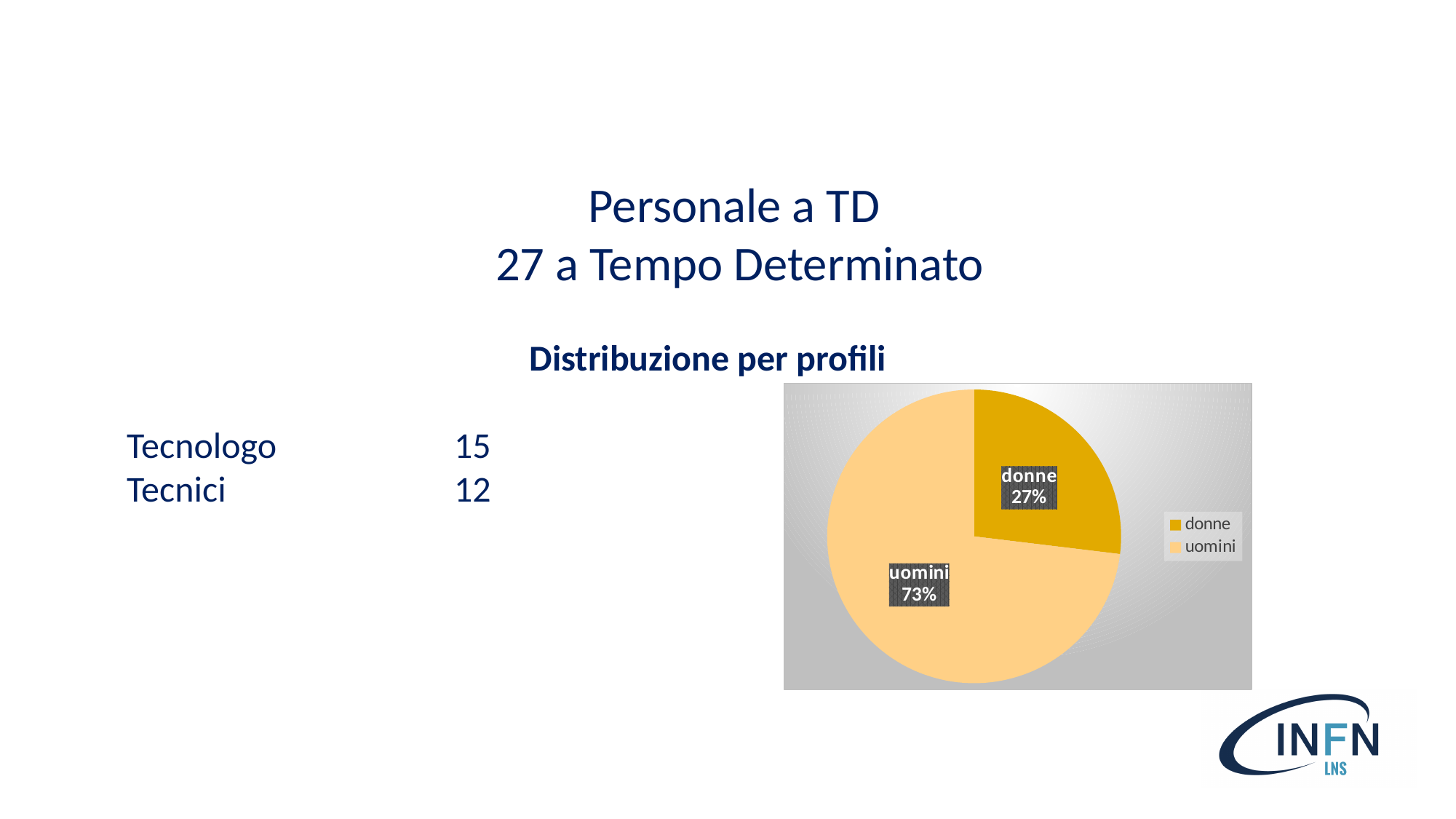
Which slice of the pie chart is the largest? uomini What share of the pie does the "uomini" slice represent? 73% Where is the legend positioned relative to the pie? to the right of the pie Which colour is used for the "donne" slice in the pie chart? dark yellow (gold) What is the difference in percentage points between the uomini share and the donne share? 46% How many slices does the pie chart have? 2 What share of the pie does the "donne" slice represent? 27% How many entries does the legend of the pie chart list? 2 Which is larger in the pie chart, the share for donne or the share for uomini? uomini What kind of chart is shown on the slide? pie chart Which slice of the pie chart is the smallest? donne